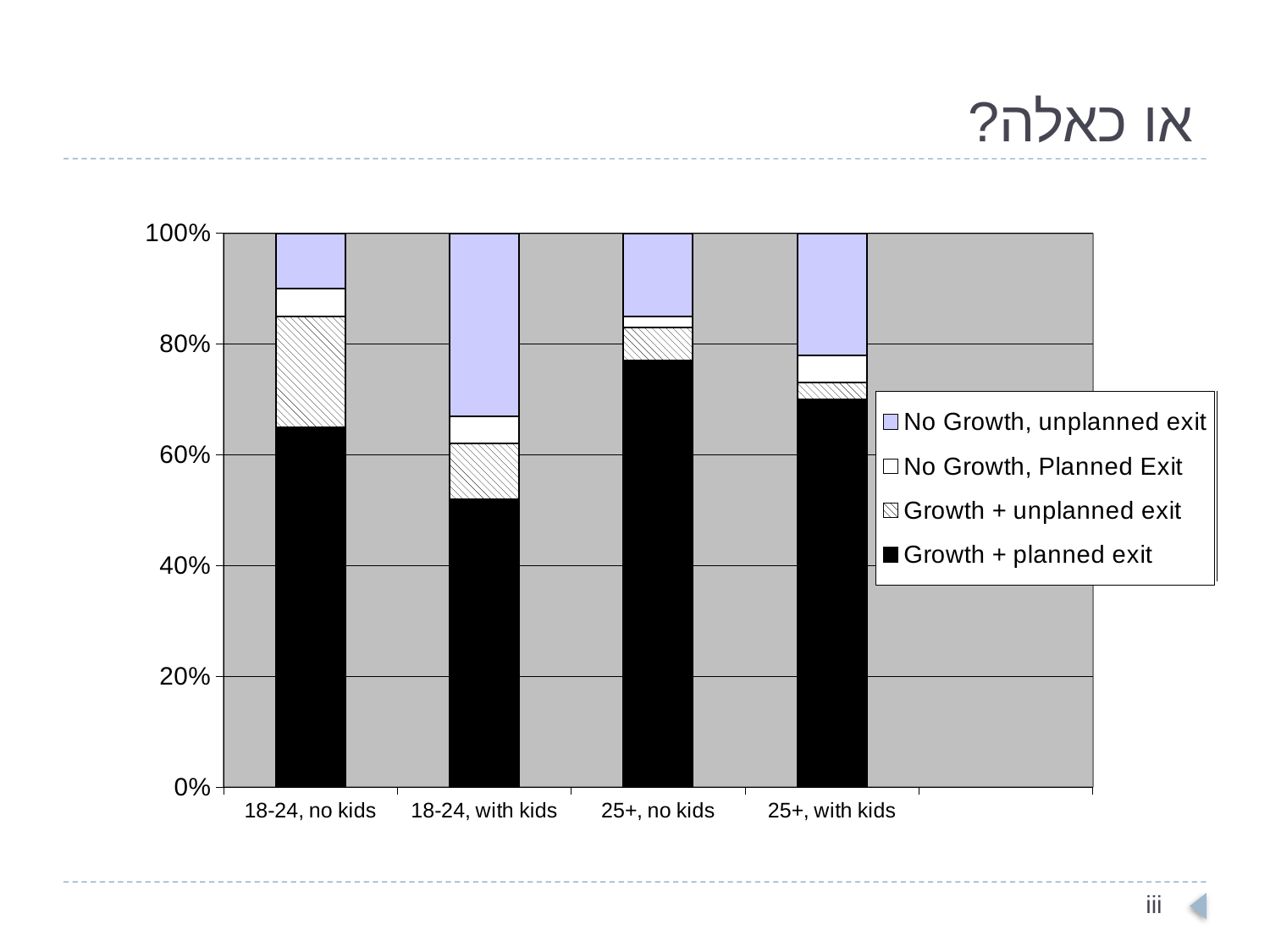
Is the Growth + planned exit value for 25+, no kids greater or less than 80%? less Which legend entry is shown with a solid black fill? Growth + planned exit Which has a larger Growth + planned exit segment: 25+, with kids or 18-24, with kids? 25+, with kids Which category has the largest No Growth, unplanned exit segment? 18-24, with kids What kind of chart is shown on the slide? stacked bar chart What is the total of the stacked bar for 25+, no kids? 100% How many categories are shown on the x axis of the chart? 4 Is the Growth + planned exit value for 18-24, no kids greater or less than 60%? greater How many series does the chart's legend list? 4 Which category has the largest Growth + planned exit segment? 25+, no kids Is the Growth + planned exit value for 18-24, with kids greater or less than 60%? less Which category has the smallest Growth + planned exit segment? 18-24, with kids